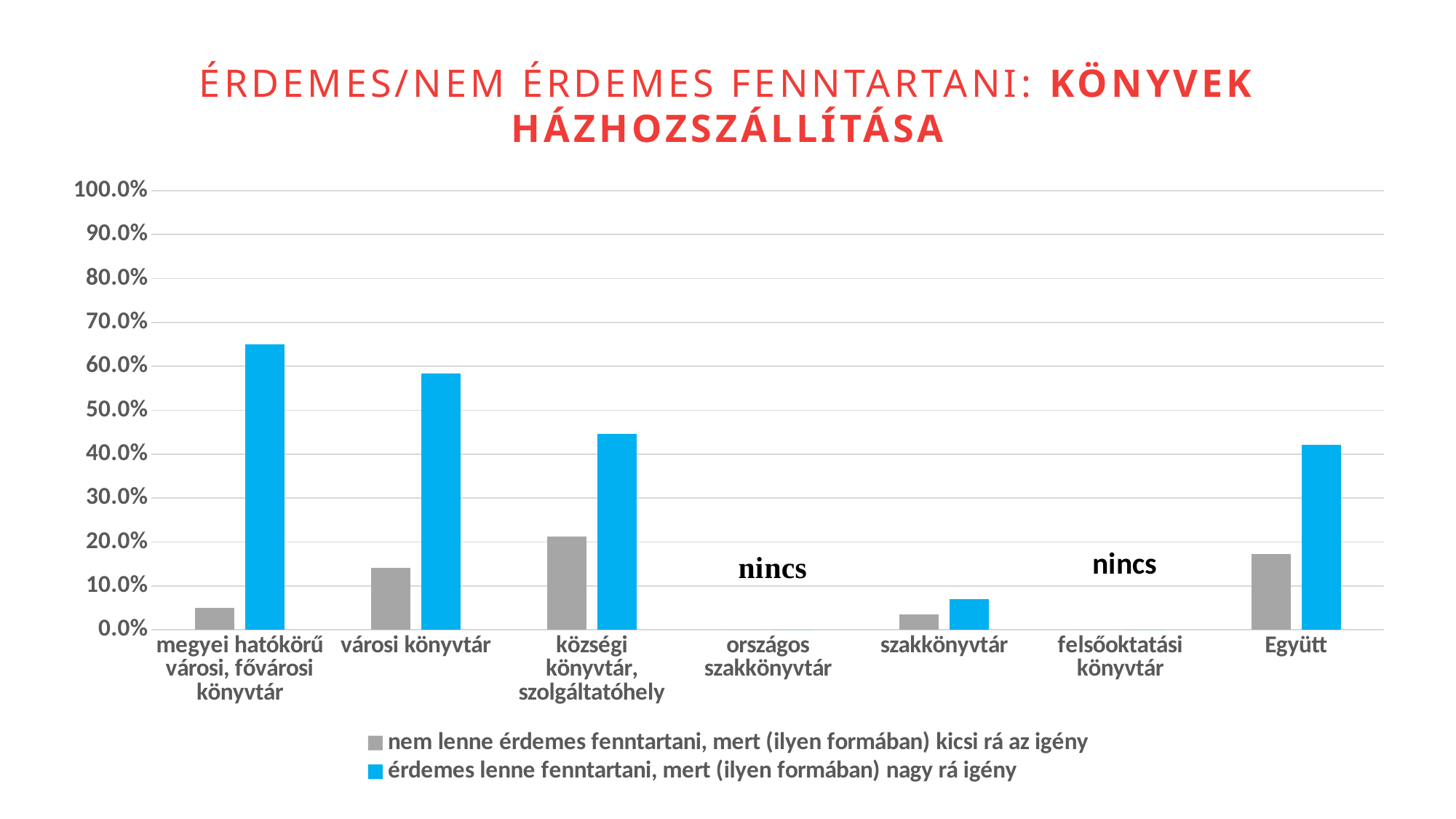
How many categories are shown on the x axis? 7 Is the value for 'megyei hatókörű városi, fővárosi könyvtár' in the series 'érdemes lenne fenntartani, mert (ilyen formában) nagy rá igény' greater or less than 60.0%? greater Is the value for 'városi könyvtár' in the series 'nem lenne érdemes fenntartani, mert (ilyen formában) kicsi rá az igény' greater or less than 20.0%? less Is the value for 'Együtt' in the series 'érdemes lenne fenntartani, mert (ilyen formában) nagy rá igény' greater or less than 50.0%? less Which two categories are marked with the word 'nincs' instead of bars? országos szakkönyvtár and felsőoktatási könyvtár Among the categories with plotted bars, which has the lowest value for the series 'érdemes lenne fenntartani, mert (ilyen formában) nagy rá igény'? szakkönyvtár Which category has the highest value for the series 'nem lenne érdemes fenntartani, mert (ilyen formában) kicsi rá az igény'? községi könyvtár, szolgáltatóhely How many series does the legend list? 2 For the series 'érdemes lenne fenntartani, mert (ilyen formában) nagy rá igény', which is larger: 'városi könyvtár' or 'Együtt'? városi könyvtár What kind of chart is shown on the slide? bar chart Which category has the highest value for the series 'érdemes lenne fenntartani, mert (ilyen formában) nagy rá igény'? megyei hatókörű városi, fővárosi könyvtár